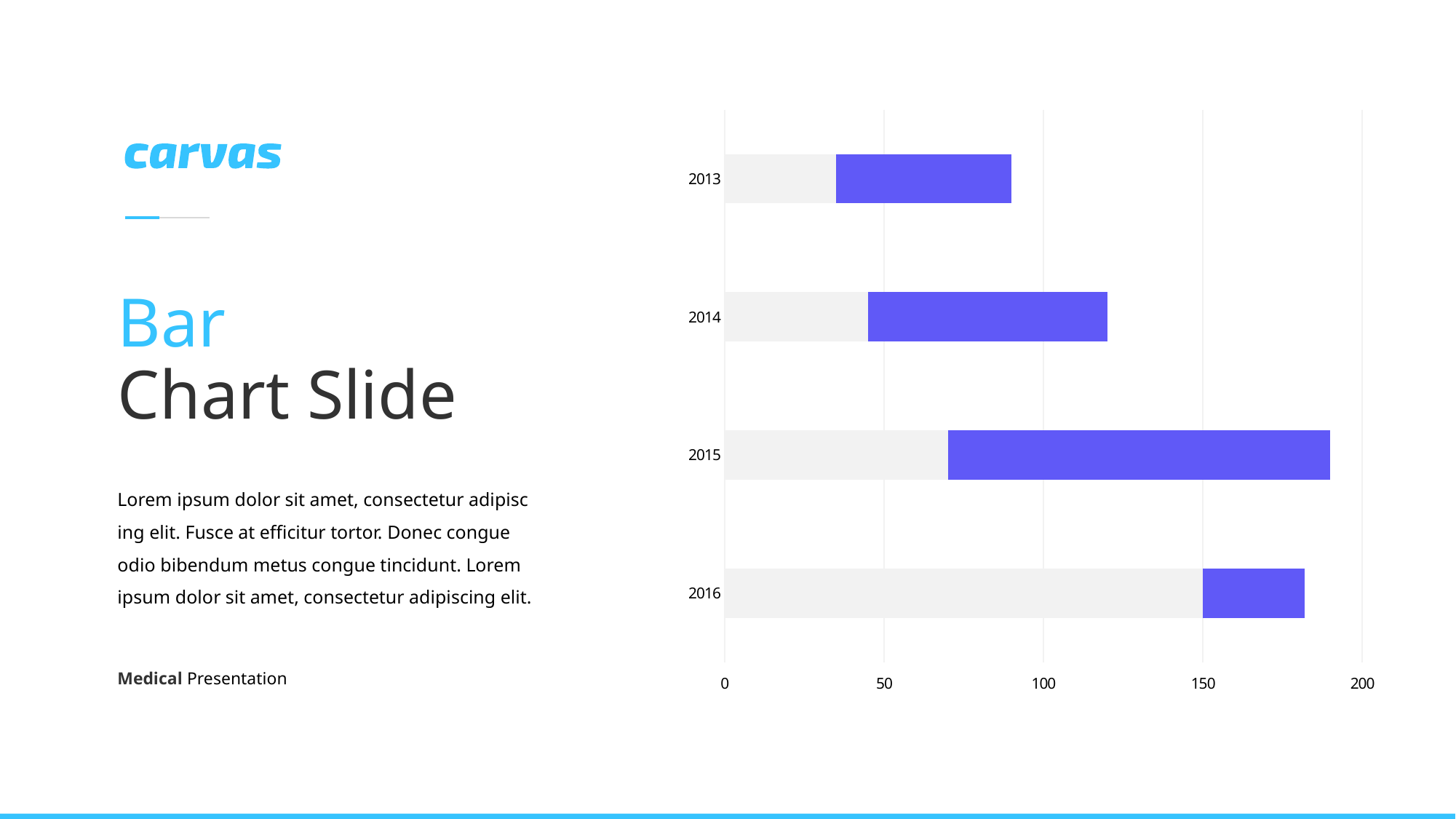
How many years are listed on the chart's vertical axis? 4 Which purple bar segment is longer, 2013 or 2014? 2014 Is the right end of the purple bar for 2013 greater or less than 100? less Is the right end of the purple bar for 2015 greater or less than 150? greater Is the right end of the purple bar for 2016 greater or less than 150? greater Which year has the shortest purple bar segment? 2016 Which year's bar extends furthest to the right on the chart? 2015 Which year has the longest purple bar segment? 2015 What is the title of the slide containing the chart? Bar Chart Slide At what axis value does the purple bar segment for 2016 begin? 150 What kind of chart is shown on the slide? bar chart